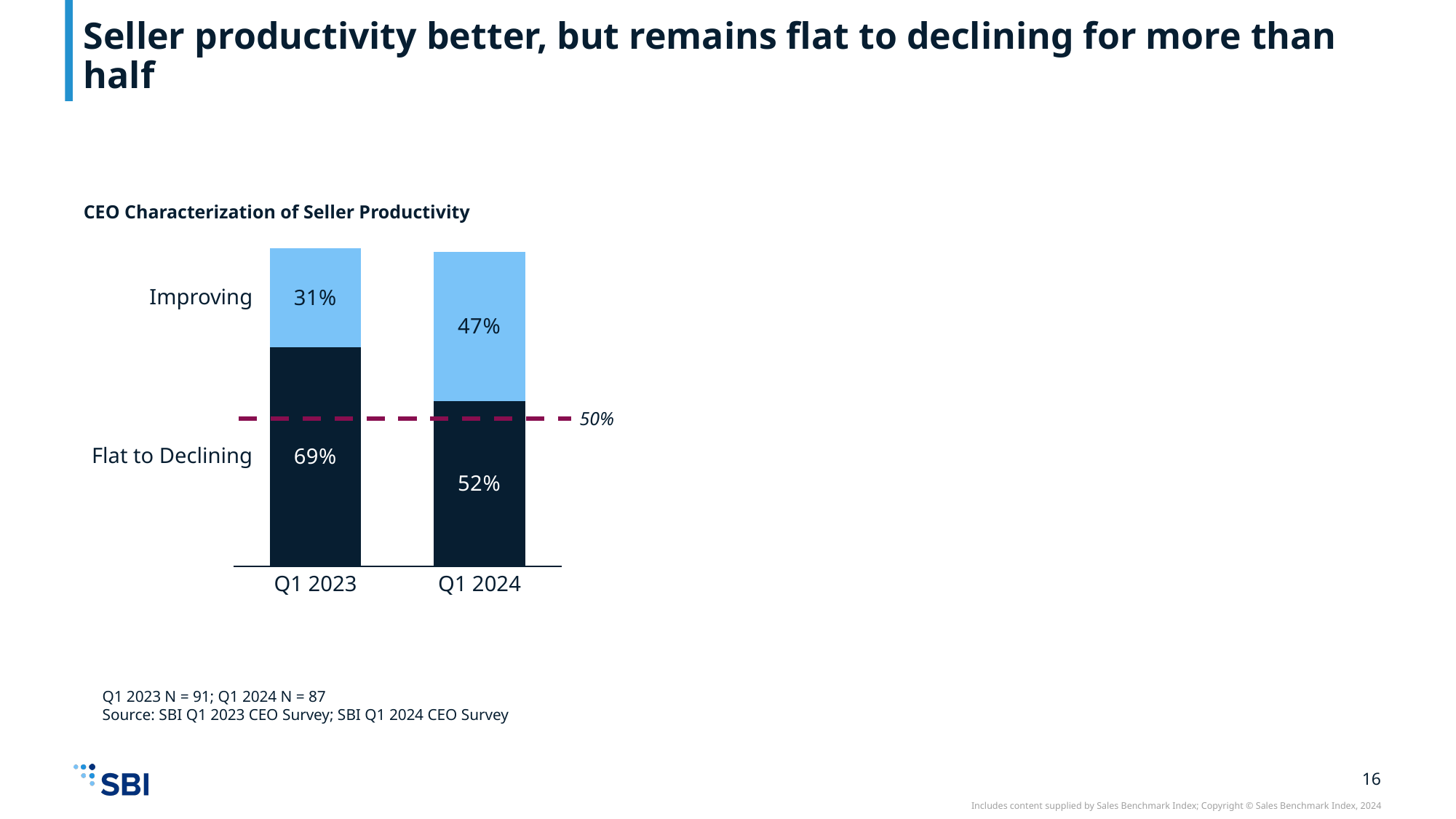
By how many percentage points did the Improving share change from Q1 2023 to Q1 2024? 16 percentage points What percentage of CEOs characterized seller productivity as Improving in Q1 2023? 31% What value does the dashed horizontal reference line mark? 50% What is the Improving value for Q1 2024? 47% What type of chart is shown on the slide? Stacked bar chart What percentage of CEOs characterized seller productivity as Flat to Declining in Q1 2024? 52% What is the Flat to Declining value for Q1 2023? 69% Is the Flat to Declining value for Q1 2024 greater or less than 50%? greater Which quarter has the higher Flat to Declining share, Q1 2023 or Q1 2024? Q1 2023 What is the difference between the Flat to Declining values for Q1 2023 and Q1 2024? 17 percentage points How many quarters (bars) are shown in the chart? 2 How many categories make up each stacked bar? 2